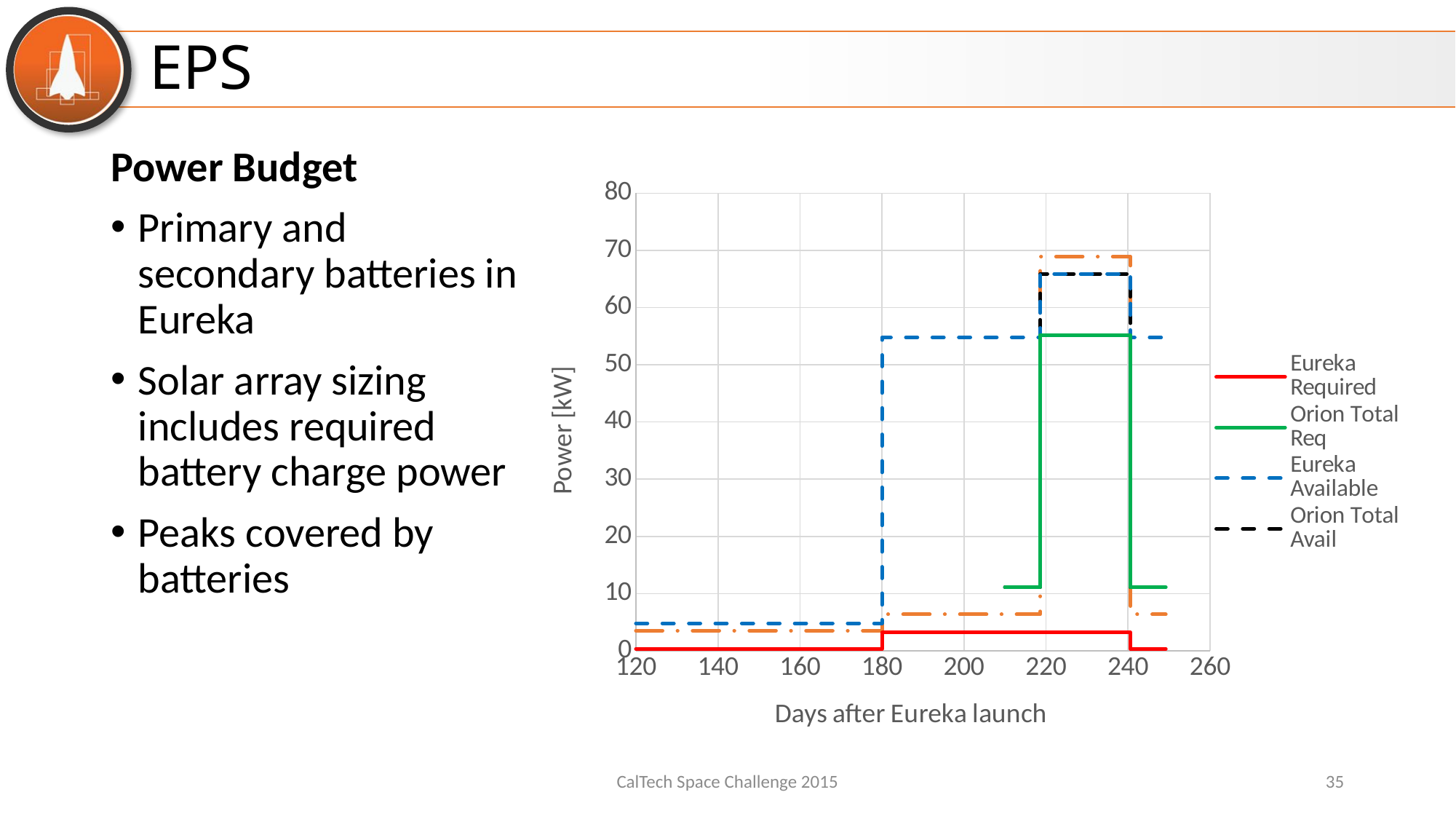
At day 230, which is larger: Orion Total Avail or Orion Total Req? Orion Total Avail Is the value of Eureka Available at day 150 greater or less than 10? less Is the value of Orion Total Req at day 230 greater or less than 50? greater What is the label of the y axis of the chart? Power [kW] What is the label of the x axis of the chart? Days after Eureka launch How many series does the chart legend list? 4 Is the value of Orion Total Req at day 215 greater or less than 20? less What kind of chart is shown on the slide? line chart Does the Eureka Available line rise or fall between day 160 and day 200? rise